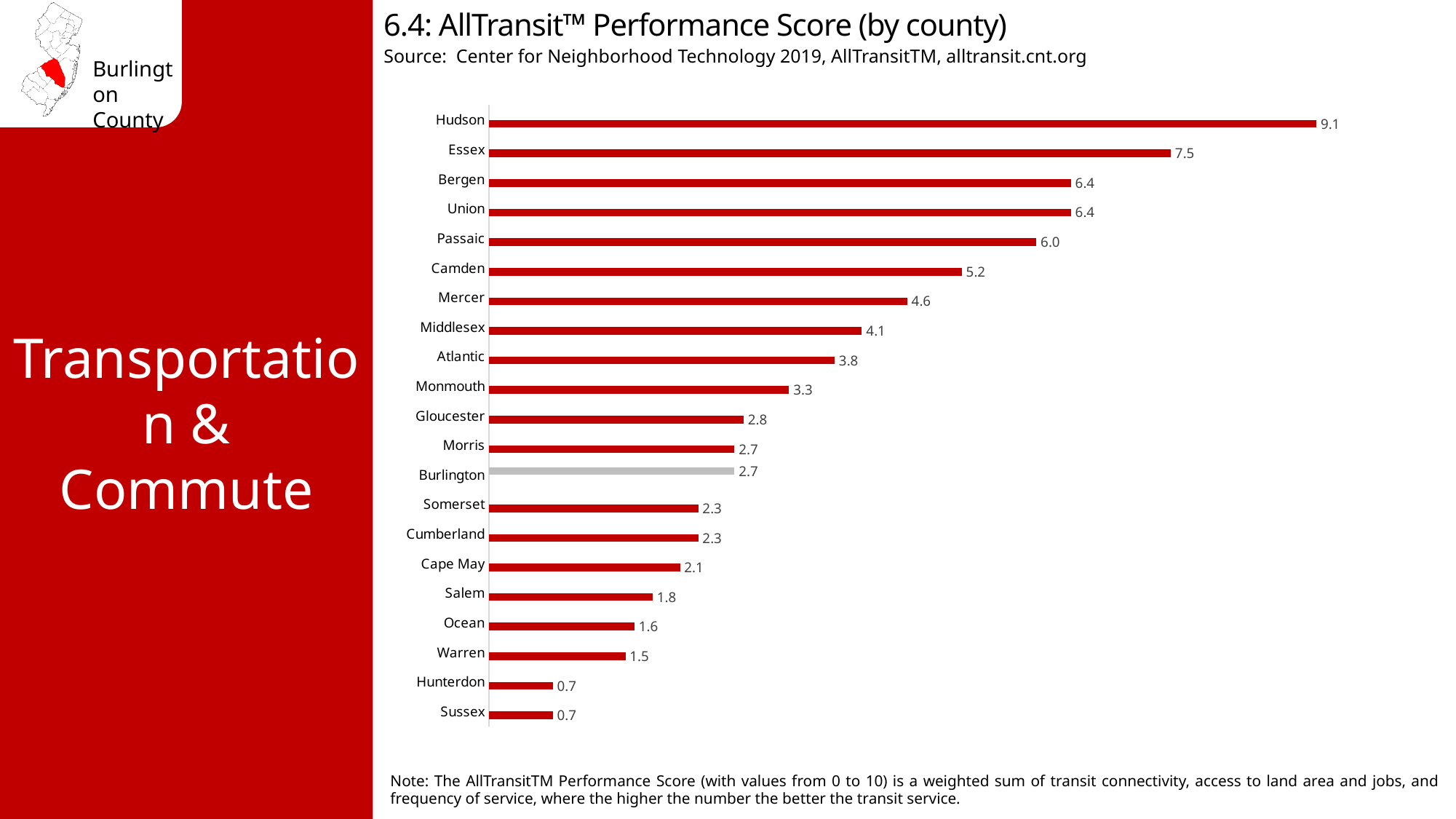
What is the AllTransit Performance Score for Sussex County? 0.7 What is the difference between the AllTransit Performance Scores of Camden and Burlington counties? 2.5 Which county has a higher AllTransit Performance Score, Passaic or Middlesex? Passaic What is the difference between the AllTransit Performance Scores of Hudson and Essex counties? 1.6 What kind of chart is used to show the AllTransit Performance Score by county? Bar chart What is the AllTransit Performance Score for Mercer County? 4.6 What is the AllTransit Performance Score for Camden County? 5.2 Which county's bar is shown in a different colour (grey) from the others? Burlington What is the AllTransit Performance Score for Burlington County? 2.7 Which county has the highest AllTransit Performance Score? Hudson Which county has a higher AllTransit Performance Score, Monmouth or Gloucester? Monmouth How many counties are shown in the chart? 21